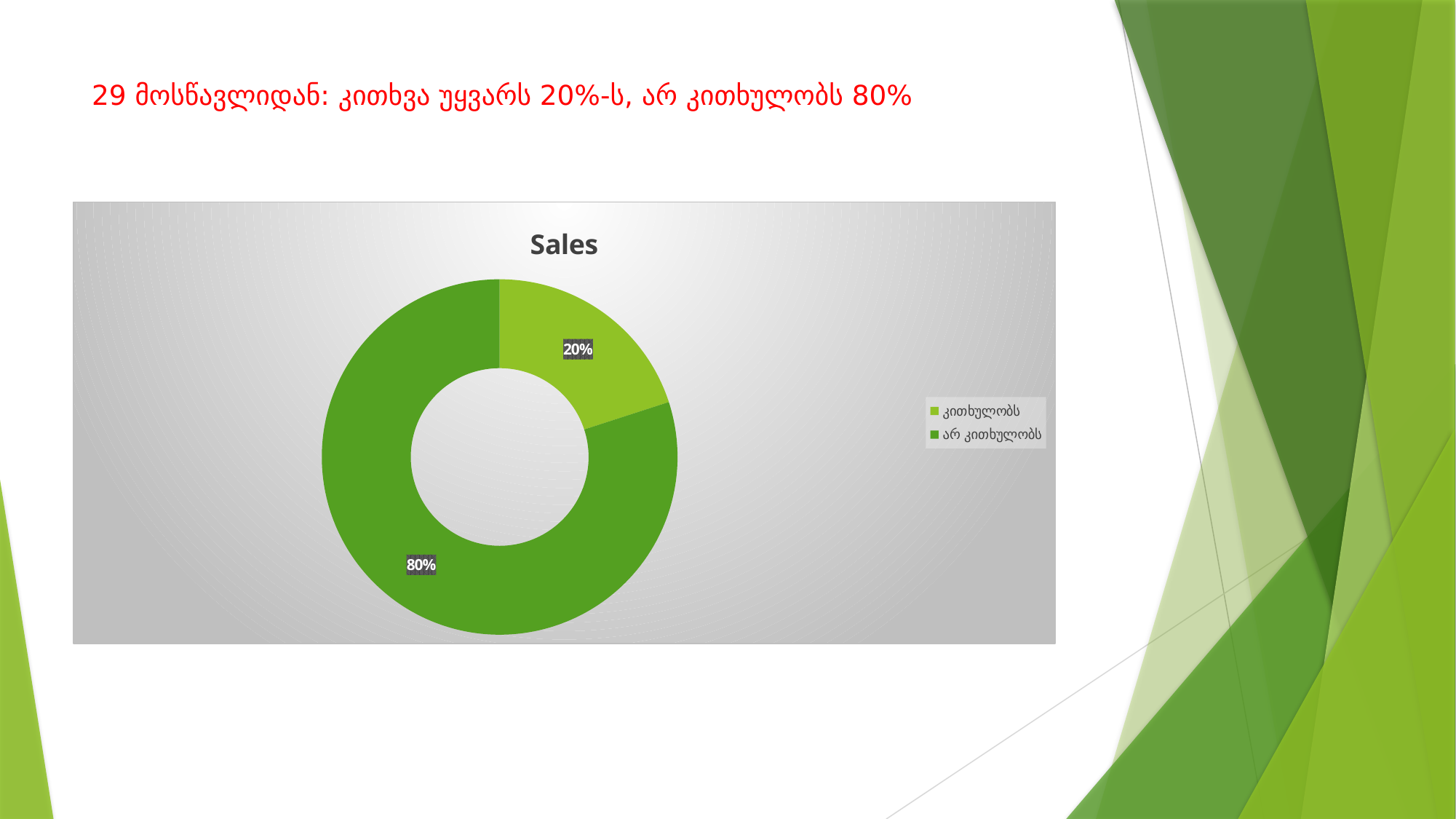
What is the difference between the share for არ კითხულობს and the share for კითხულობს? 60% Which category has the largest share of the chart? არ კითხულობს What kind of chart is shown on the slide? Doughnut chart What is the value shown for არ კითხულობს? 80% How many categories are shown in the chart? 2 What is the title of the chart? Sales What is the value shown for კითხულობს? 20% Which legend entry is shown in the darker green colour? არ კითხულობს Which category has the smallest share of the chart? კითხულობს How many entries does the legend list? 2 What share of the chart does the კითხულობს slice represent? 20% Which is larger, the share for კითხულობს or the share for არ კითხულობს? არ კითხულობს